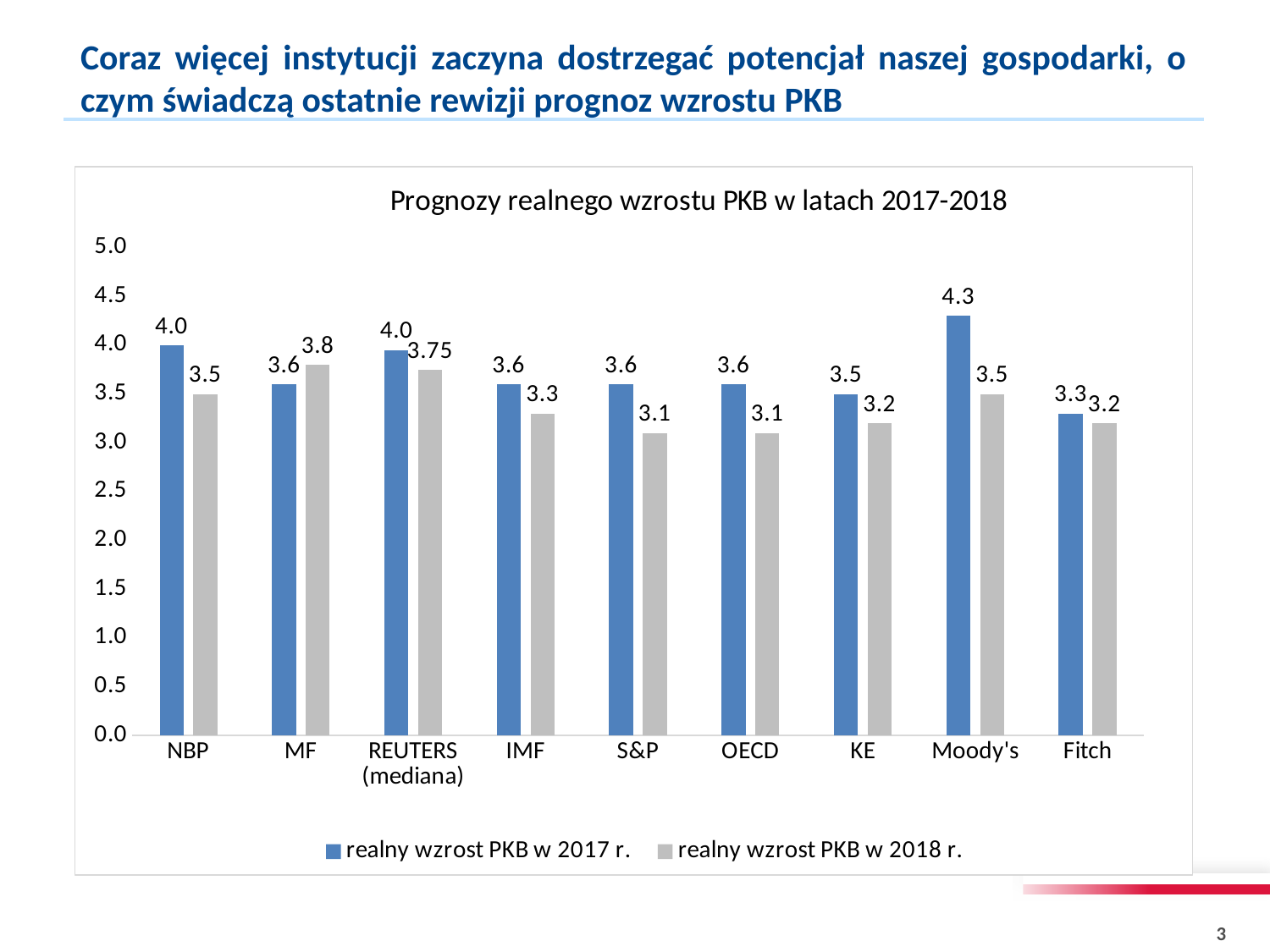
What is the forecast for real GDP growth in 2017 from NBP? 4.0 What is the forecast for real GDP growth in 2018 from REUTERS (mediana)? 3.75 What is the title of the chart? Prognozy realnego wzrostu PKB w latach 2017-2018 Which is larger for MF: the 2017 forecast or the 2018 forecast? 2018 forecast Which institution has the highest forecast for real GDP growth in 2017? Moody's What is the 2018 real GDP growth forecast from Fitch? 3.2 How many institutions are shown on the x axis of the chart? 9 Which institution has the lowest forecast for real GDP growth in 2017? Fitch Is the 2018 real GDP growth forecast from S&P greater or less than 3.5? less How many series does the legend list? 2 What is the difference between Moody's 2017 and 2018 real GDP growth forecasts? 0.8 What kind of chart is shown on the slide? bar chart